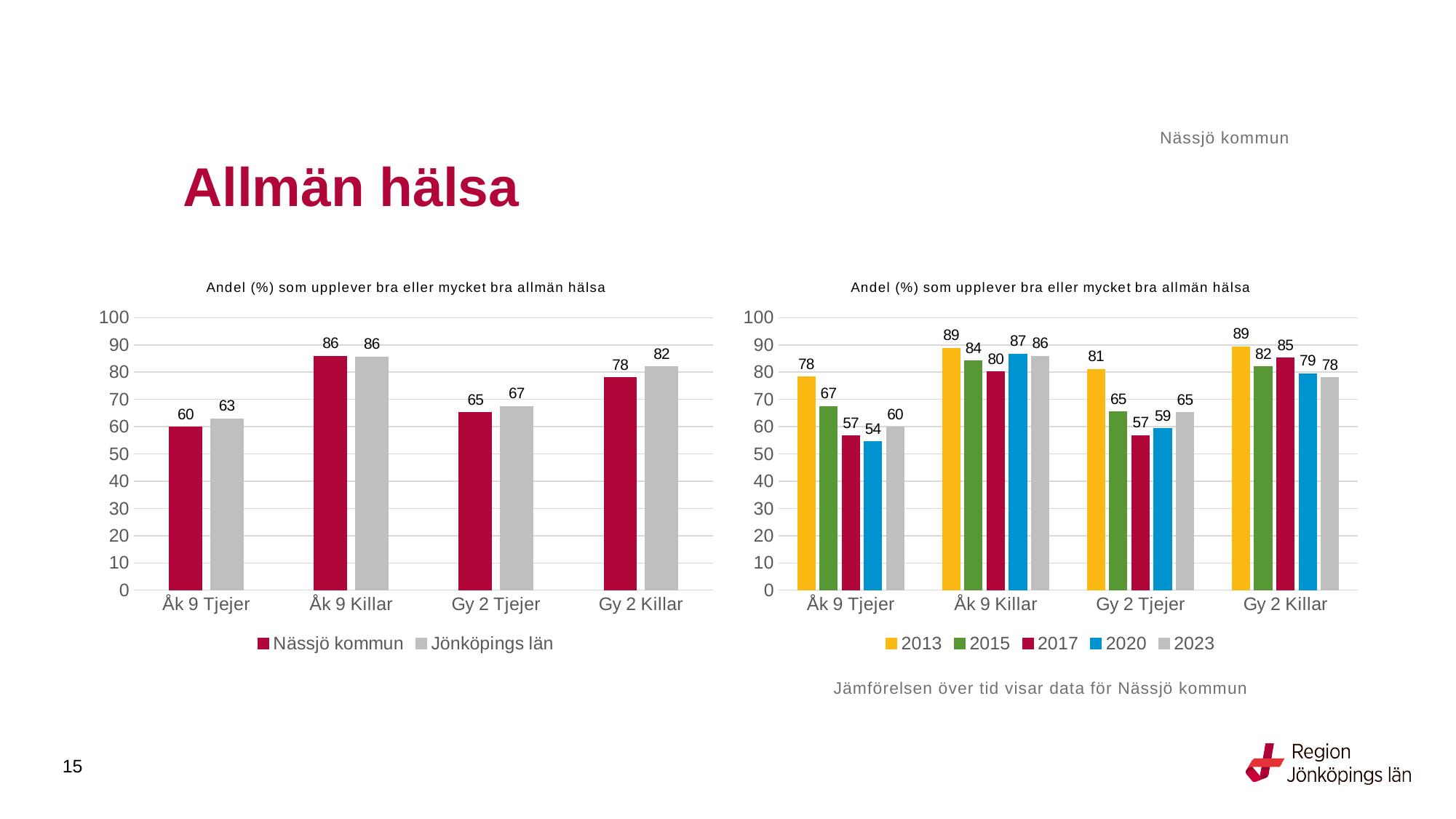
In the left chart, how many series does the legend list? 2 In the left chart, what is the difference between Jönköpings län and Nässjö kommun for Gy 2 Killar? 4 In the left chart, what is the value for Nässjö kommun for Åk 9 Tjejer? 60 In the right chart, which year has the lowest value for Åk 9 Tjejer? 2020 In the right chart, how many categories are shown on the x axis? 4 In the right chart, what is the value for 2017 for Åk 9 Tjejer? 57 In the left chart, what is the value for Jönköpings län for Gy 2 Killar? 82 In the right chart, is the value for 2013 for Gy 2 Killar larger than the value for 2023 for Gy 2 Killar? Yes What kind of chart is the left chart? Bar chart In the right chart, how many series does the legend list? 5 In the left chart, which category has the highest value for Nässjö kommun? Åk 9 Killar In the right chart, what is the value for 2023 for Gy 2 Tjejer? 65